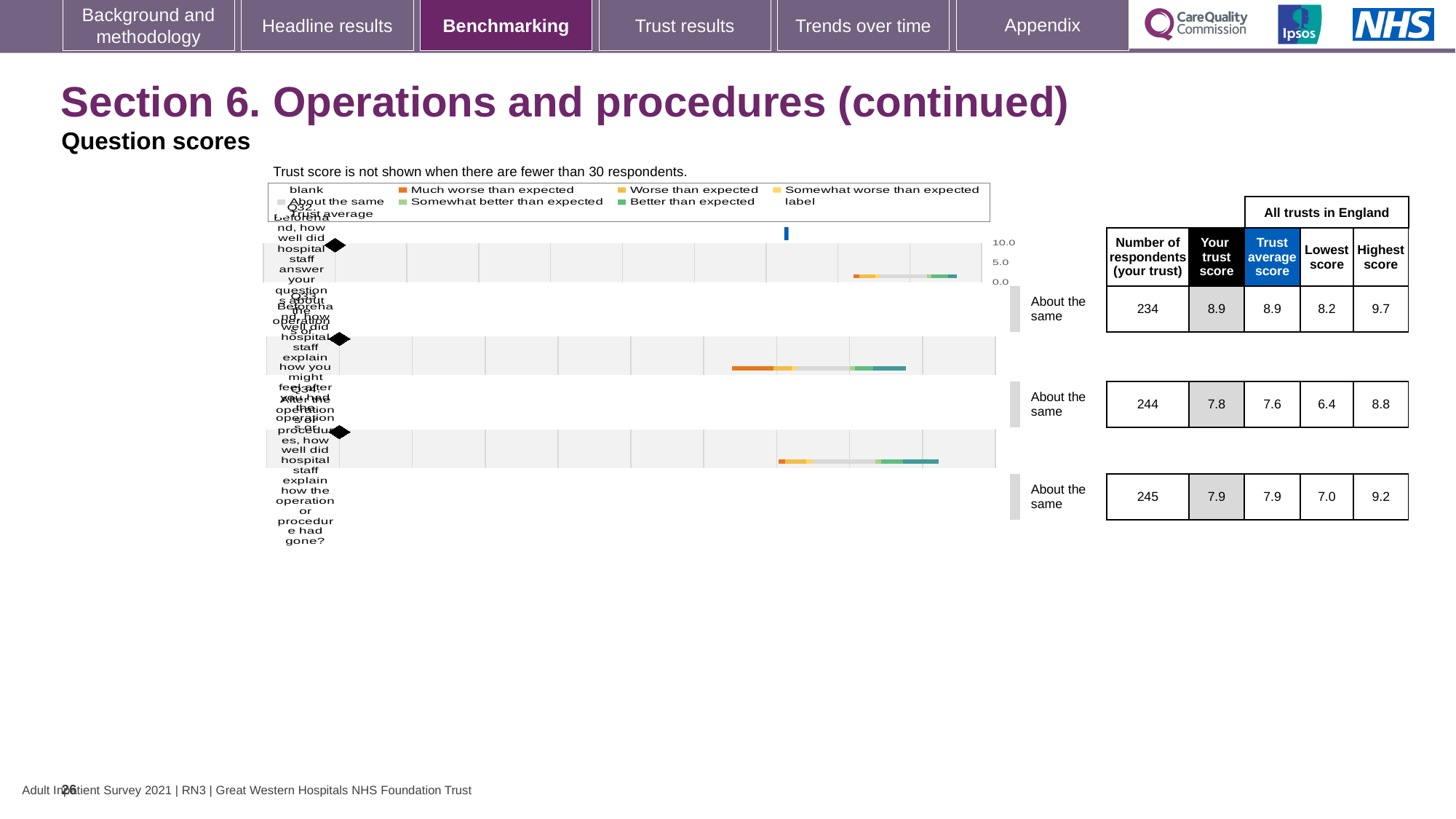
Which question row has the highest 'Your trust score'? the first (top) row, 8.9 For the second question row, what is the difference between the trust average score and the lowest score? 1.2 What benchmark category is shown next to each of the three question rows? About the same What is the highest score across all trusts in England for the third (bottom) question row? 9.2 For the second question row, which is larger: 'Your trust score' or the 'Trust average score'? Your trust score According to the note above the chart, when is the trust score not shown? when there are fewer than 30 respondents Is 'Your trust score' for the first question row greater or less than 5.0? greater What kind of chart is used to show the question scores on this slide? bar chart What is the number of respondents for the first (top) question row? 234 How many questions (rows) are shown in the benchmarking chart? 3 What is 'Your trust score' for the second question row? 7.8 What is the lowest score across all trusts in England for the first (top) question row? 8.2